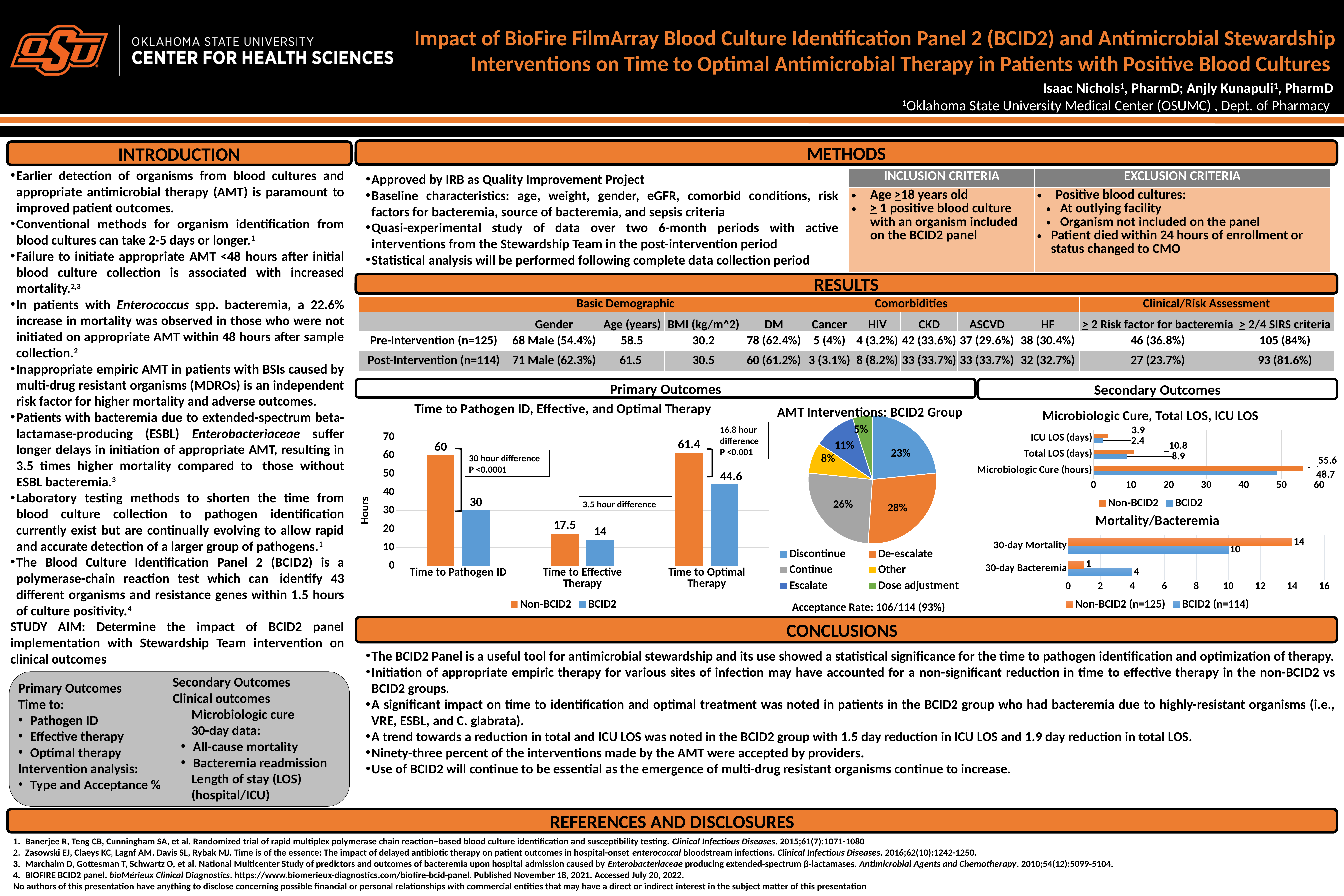
How many series does the legend of the 'Mortality/Bacteremia' chart list? 2 In the 'AMT Interventions: BCID2 Group' pie chart, which intervention has the smallest share? Dose adjustment What kind of chart is 'Time to Pathogen ID, Effective, and Optimal Therapy'? Bar chart In the 'Time to Pathogen ID, Effective, and Optimal Therapy' chart, what is the Non-BCID2 value for Time to Pathogen ID? 60 In the 'Time to Pathogen ID, Effective, and Optimal Therapy' chart, what is the difference between the Non-BCID2 and BCID2 values for Time to Effective Therapy? 3.5 How many slices does the 'AMT Interventions: BCID2 Group' pie chart have? 6 In the 'Time to Pathogen ID, Effective, and Optimal Therapy' chart, which category has the lowest BCID2 value? Time to Effective Therapy In the 'Mortality/Bacteremia' chart, what is the BCID2 (n=114) value for 30-day Bacteremia? 4 In the 'AMT Interventions: BCID2 Group' pie chart, what share is De-escalate? 28% In the 'Microbiologic Cure, Total LOS, ICU LOS' chart, which is larger for Total LOS (days): Non-BCID2 or BCID2? Non-BCID2 In the 'Microbiologic Cure, Total LOS, ICU LOS' chart, what is the BCID2 value for Microbiologic Cure (hours)? 48.7 In the 'Time to Pathogen ID, Effective, and Optimal Therapy' chart, what is the BCID2 value for Time to Optimal Therapy? 44.6